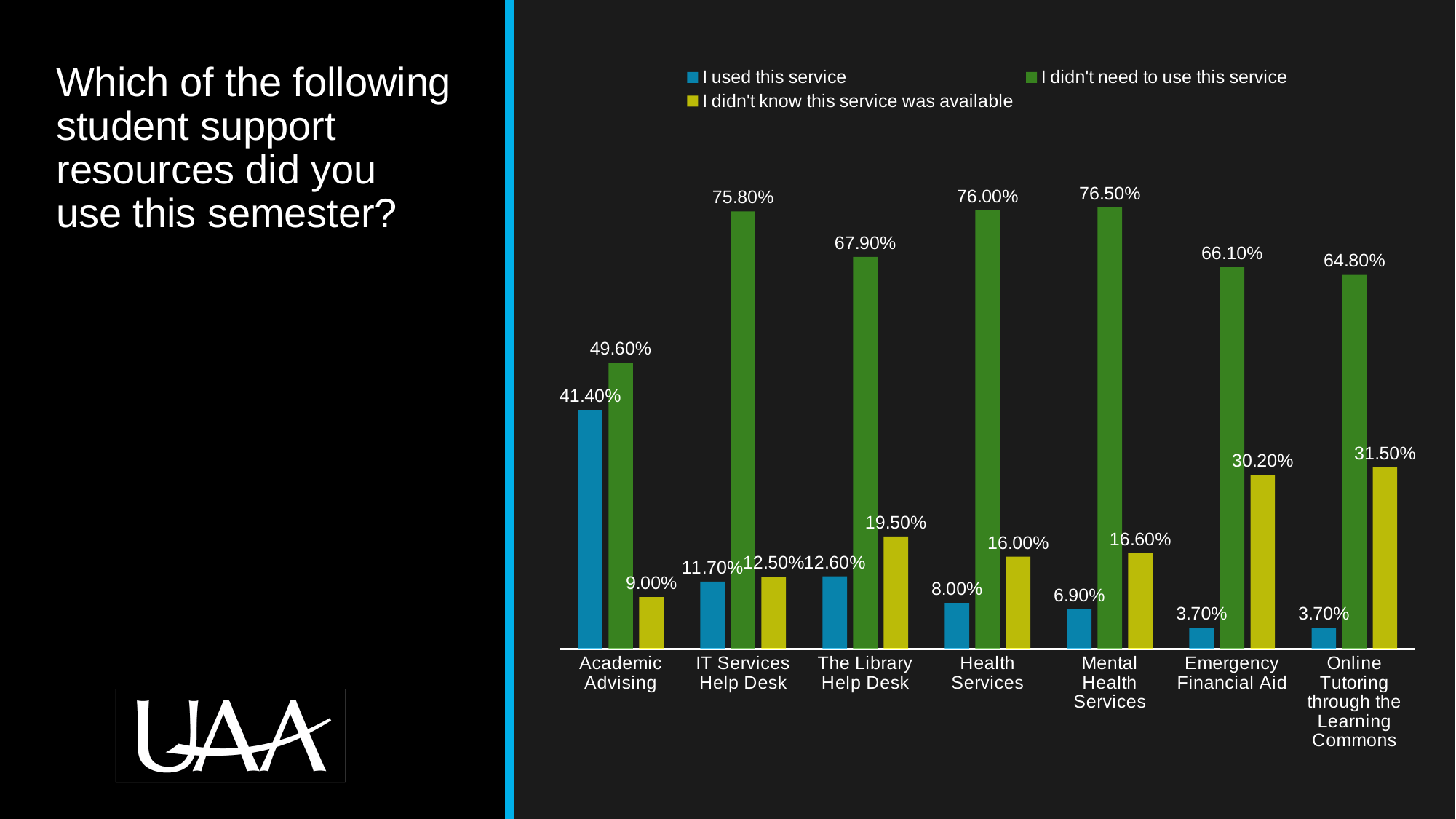
Which resource has the highest value for "I used this service"? Academic Advising What is the value for "I used this service" for Emergency Financial Aid? 3.70% What kind of chart is shown on the slide? Bar chart What percentage of respondents said they used Academic Advising this semester? 41.40% Which resource has the lowest value for "I didn't know this service was available"? Academic Advising What is the value for "I didn't need to use this service" for Mental Health Services? 76.50% Which is larger for The Library Help Desk: "I used this service" or "I didn't know this service was available"? I didn't know this service was available What percentage of respondents didn't know Online Tutoring through the Learning Commons was available? 31.50% How many student support resources are shown on the x axis? 7 How many series does the legend list? 3 For Academic Advising, what is the difference between "I didn't need to use this service" and "I used this service"? 8.20% Which resource has the highest value for "I didn't know this service was available"? Online Tutoring through the Learning Commons